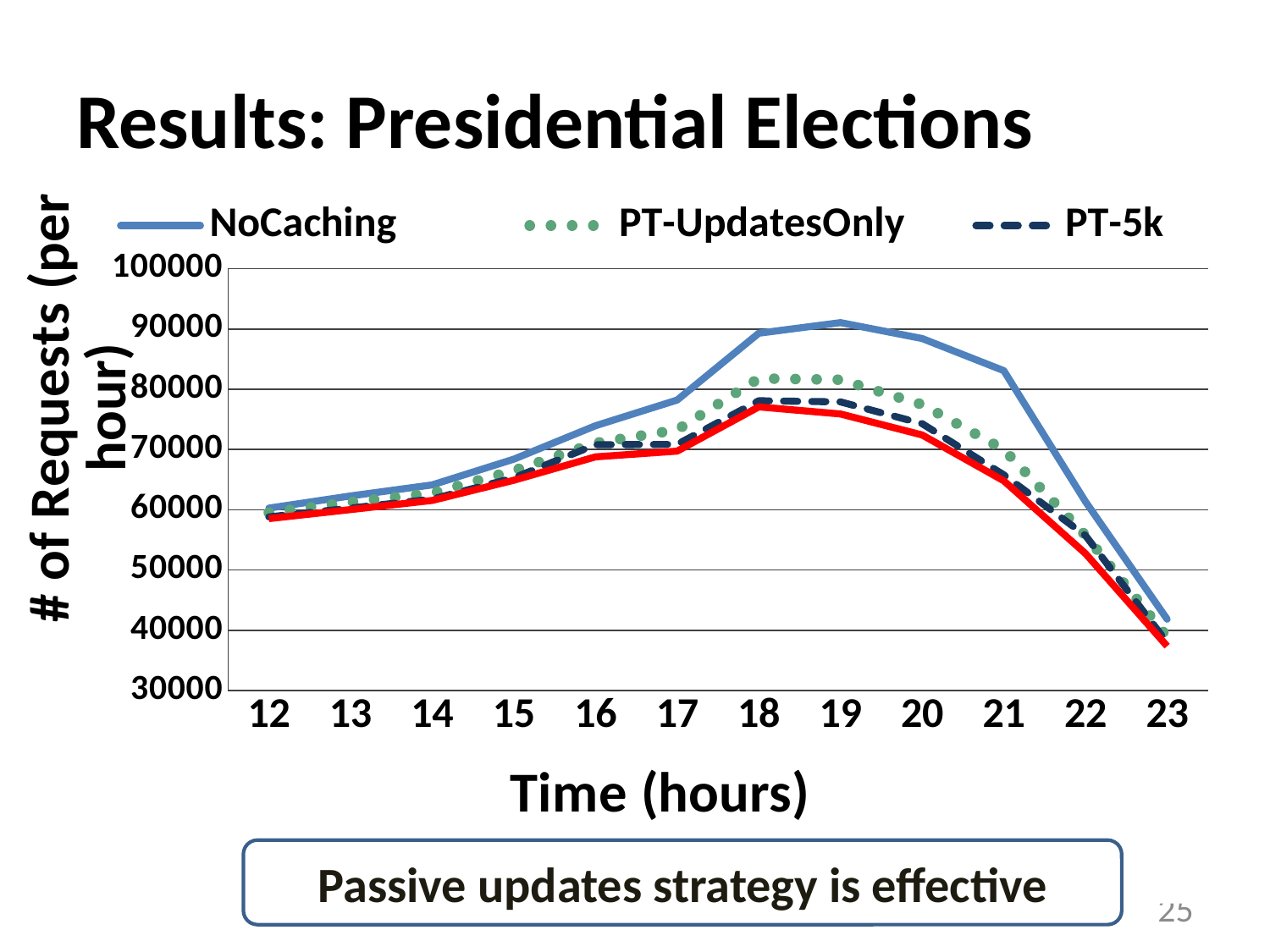
At which hour does the NoCaching line reach its lowest value? 23 What is the label of the x axis? Time (hours) Does the NoCaching line rise or fall from hour 19 to hour 23? fall How many hour points are shown along the x axis? 12 Is the PT-5k value at hour 12 greater or less than 70000? less Is the NoCaching value at hour 23 greater or less than 50000? less How many series does the legend list? 3 Is the NoCaching value at hour 18 greater or less than 80000? greater What kind of chart is shown on the slide? line chart At which hour does the NoCaching line reach its highest value? 19 At hour 18, which is larger: NoCaching or PT-5k? NoCaching